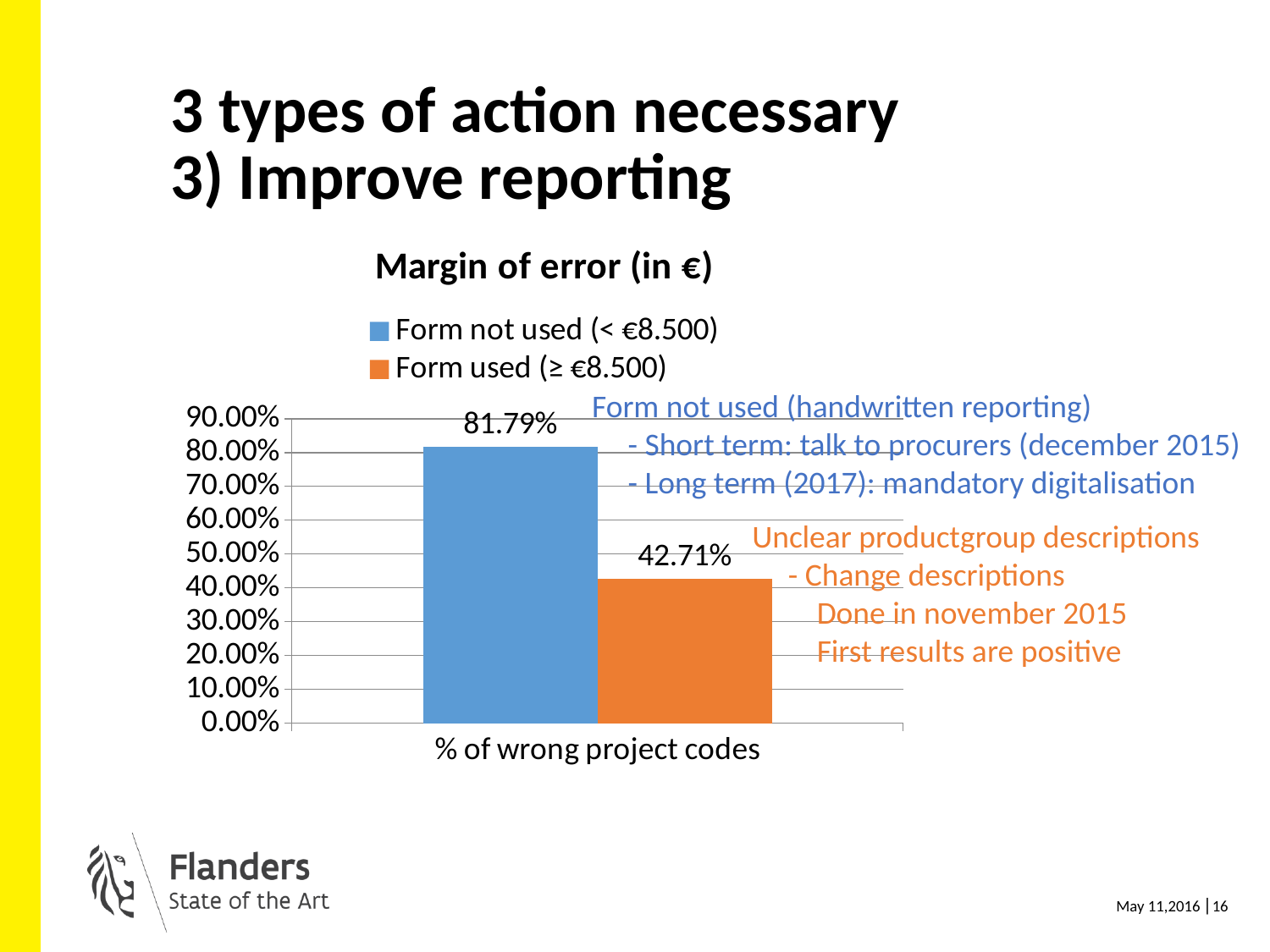
What is the value for "Form not used (< €8.500)" in the chart? 81.79% Is the value for "Form not used (< €8.500)" greater or less than 80.00%? greater Which series has the higher value in the chart? Form not used (< €8.500) What is the value for "Form used (≥ €8.500)" in the chart? 42.71% What is the difference between the values for "Form not used (< €8.500)" and "Form used (≥ €8.500)"? 39.08% Which series has the lower value in the chart? Form used (≥ €8.500) What kind of chart is shown on the slide? bar chart Is the value for "Form used (≥ €8.500)" greater or less than 50.00%? less What is the title of the chart? Margin of error (in €) Is the value for "Form used (≥ €8.500)" larger or smaller than the value for "Form not used (< €8.500)"? smaller How many series does the legend list? 2 What is the category label on the x axis of the chart? % of wrong project codes